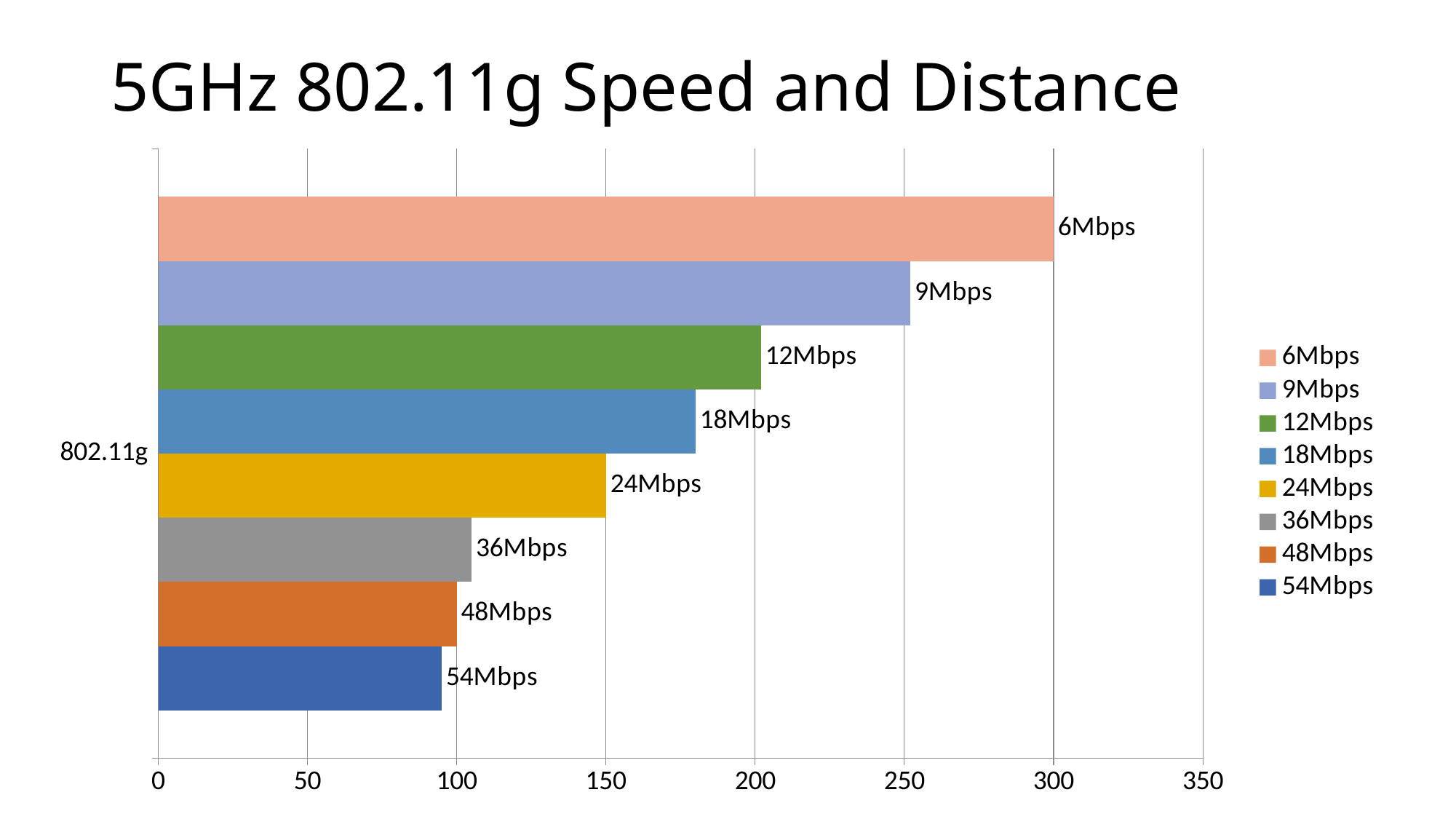
Which series has the shortest bar? 54Mbps How many categories are shown on the vertical axis? 1 Is the value for 54Mbps greater or less than 100? less How many series does the legend list? 8 What is the title of the chart? 5GHz 802.11g Speed and Distance Which is larger, the value for 12Mbps or the value for 36Mbps? 12Mbps What is the value for the 6Mbps series? 300 Is the value for 18Mbps greater or less than 200? less Which series has the longest bar? 6Mbps What kind of chart is shown on the slide? bar chart Is the value for 9Mbps greater or less than 200? greater What is the value for the 24Mbps series? 150